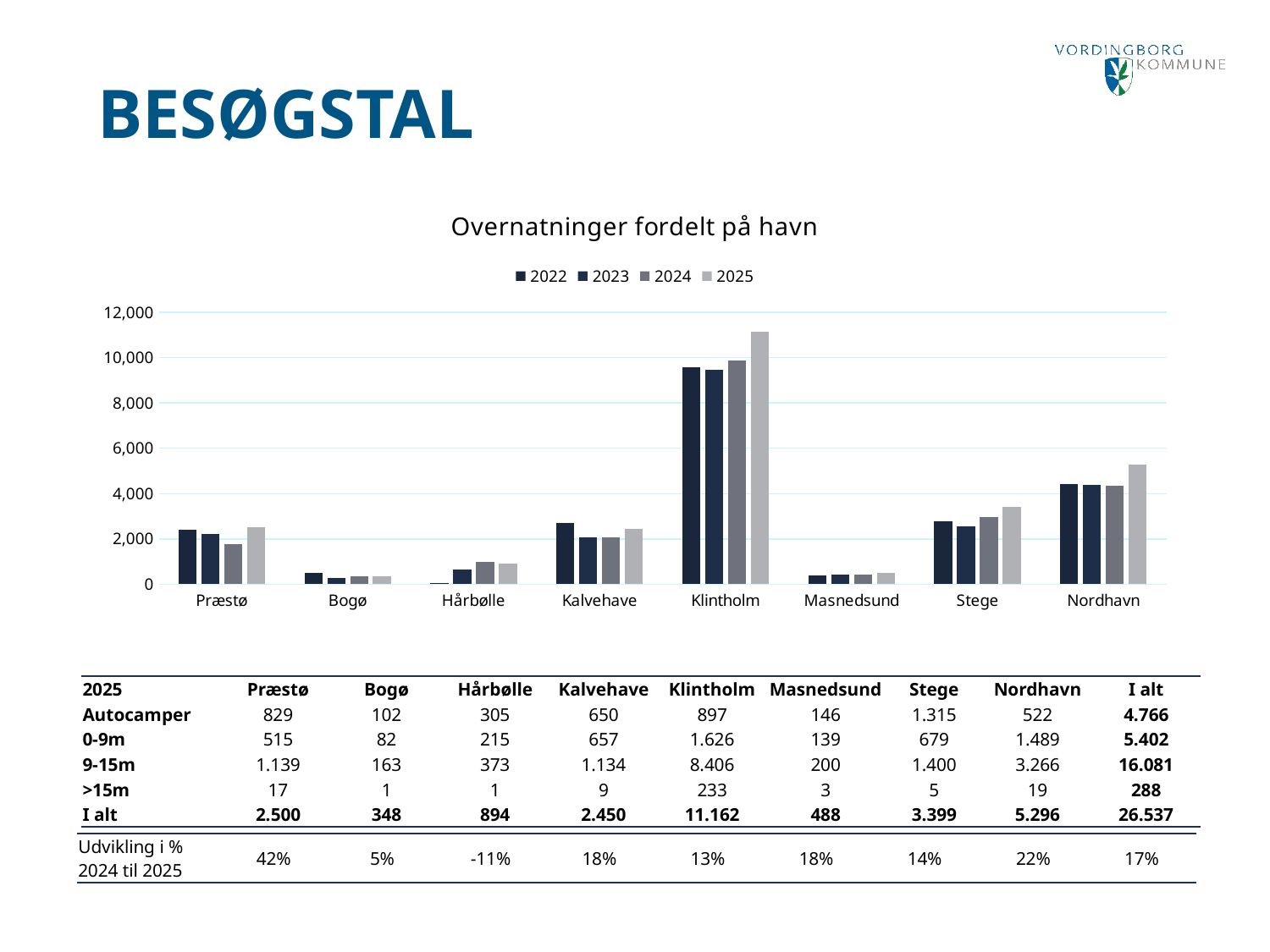
Do the bars for Klintholm rise or fall from 2022 to 2025? rise Which harbour has the lowest 2022 bar in the chart? Hårbølle How many harbours are shown along the x axis of the chart? 8 According to the table below the chart, what is the 2025 total (I alt) for Klintholm? 11.162 What kind of chart is shown on the slide? bar chart Which harbour has the highest bar in the chart? Klintholm Is the 2024 value for Præstø greater or less than 2,000? less How many series does the legend of the chart list? 4 Is the 2025 value for Klintholm greater or less than 10,000? greater What is the title of the chart? Overnatninger fordelt på havn Is the 2025 value for Nordhavn greater or less than 4,000? greater Which is larger in 2025, the value for Stege or the value for Kalvehave? Stege